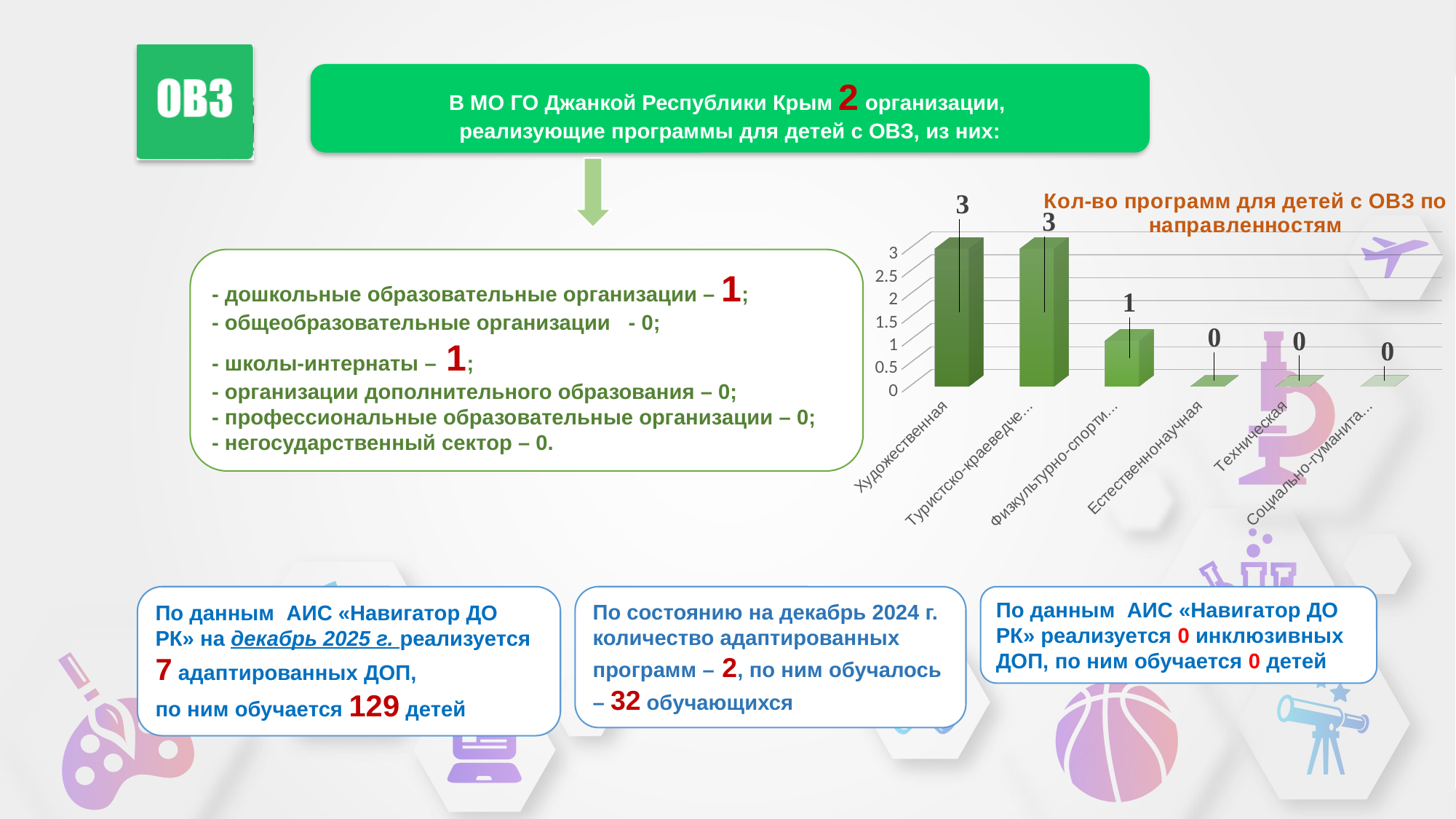
Do the values generally rise or fall moving from left to right along the x axis? fall What is the value for the category beginning with Физкультурно-спорти…? 1 How many categories are plotted in the chart? 6 What is the title of the chart? Кол-во программ для детей с ОВЗ по направленностям Which is larger, the value for Художественная or the value for the category beginning with Физкультурно-спорти…? Художественная What is the value for Художественная? 3 What is the value for Техническая? 0 What kind of chart is shown on the slide? bar chart What is the value for the category beginning with Туристско-краеведче…? 3 What is the value for Естественнонаучная? 0 What is the difference between the value for Художественная and the value for the category beginning with Физкультурно-спорти…? 2 Is the value for Художественная greater or less than 2? greater